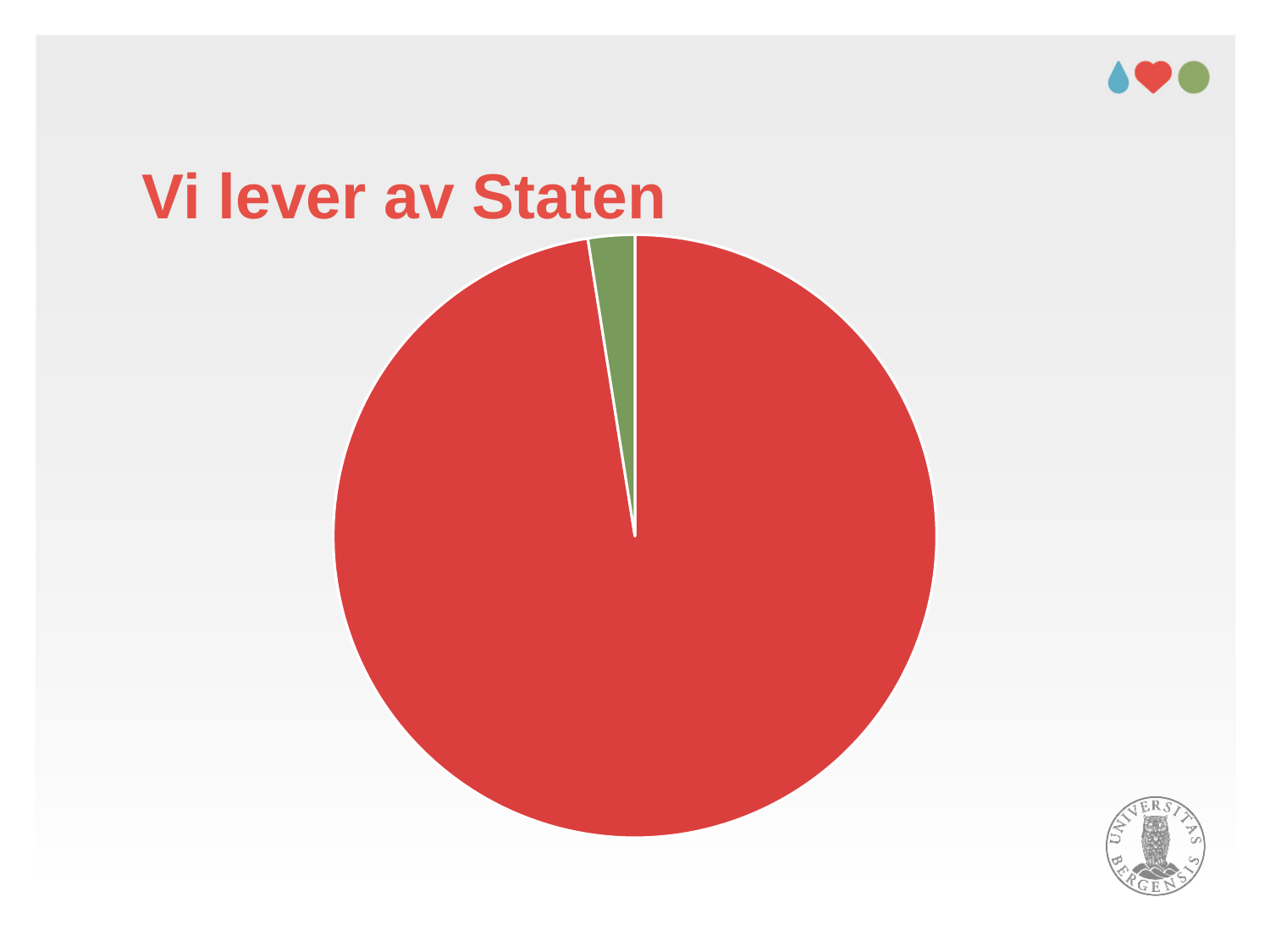
Is the red slice or the green slice larger in the pie chart? red Which colour slice is the smallest in the pie chart? green What kind of chart is shown on the slide? pie chart What is the title shown above the pie chart? Vi lever av Staten Which colour slice is the largest in the pie chart? red Does the pie chart display a legend? No How many slices does the pie chart have? 2